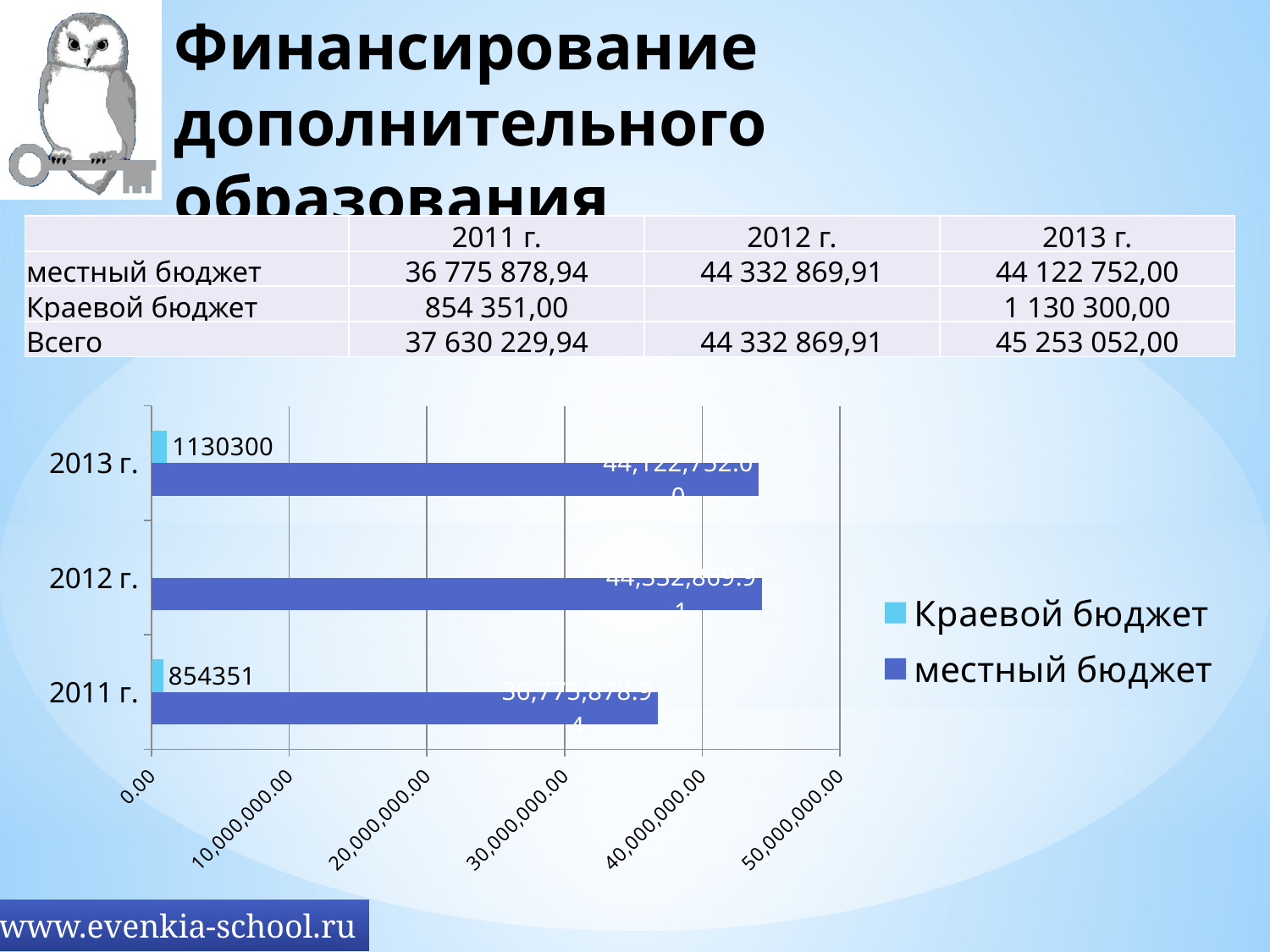
Is the value for местный бюджет in 2011 г. greater or less than 40,000,000.00? less What is the value of Краевой бюджет for 2011 г. on the chart? 854351 What is the value of Краевой бюджет for 2013 г. on the chart? 1130300 How many series does the chart legend list? 2 Which year on the chart has no Краевой бюджет bar? 2012 г. Is the value for местный бюджет in 2013 г. greater or less than 40,000,000.00? greater What kind of chart is shown on the slide? bar chart Which series has the larger bar for 2013 г.: Краевой бюджет or местный бюджет? местный бюджет Which is larger on the chart: Краевой бюджет in 2013 г. or in 2011 г.? 2013 г. Which year has the lowest местный бюджет bar on the chart? 2011 г. By how much does Краевой бюджет in 2013 г. exceed Краевой бюджет in 2011 г. on the chart? 275949 How many years are shown on the chart's vertical axis? 3